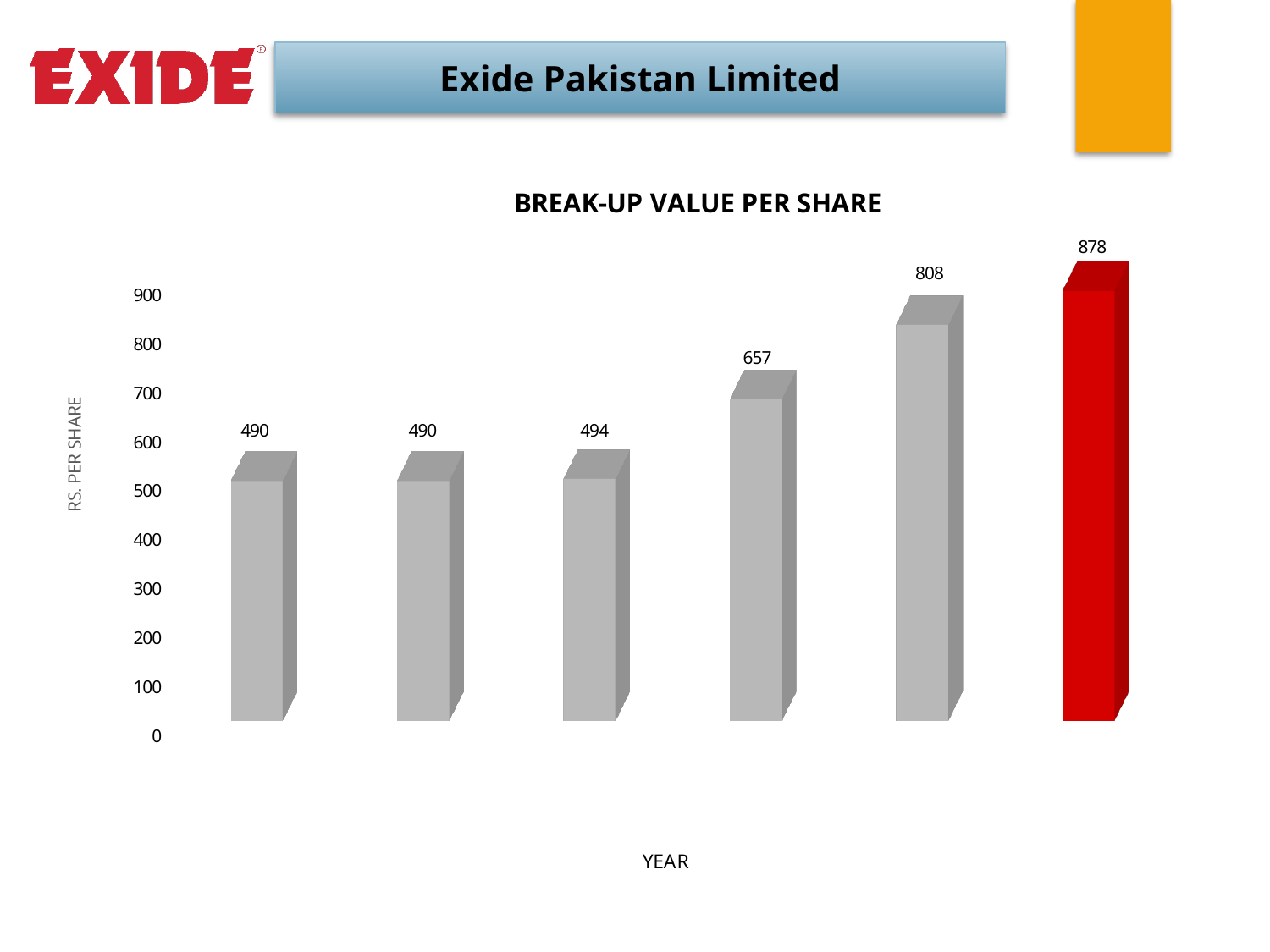
What is the lowest value shown in the chart? 490 What is the value shown on the red bar at the far right of the chart? 878 What is the value of the first (leftmost) bar in the chart? 490 How many bars are plotted in the chart? 6 What is the value of the fourth bar from the left? 657 Which is larger, the third bar or the fourth bar? the fourth bar What is the label on the vertical axis of the chart? RS. PER SHARE What is the highest value shown in the chart? 878 What is the difference between the last bar (878) and the fifth bar (808)? 70 What kind of chart is shown on the slide? bar chart What is the title of the chart? BREAK-UP VALUE PER SHARE Do the values generally rise or fall from left to right across the chart? rise